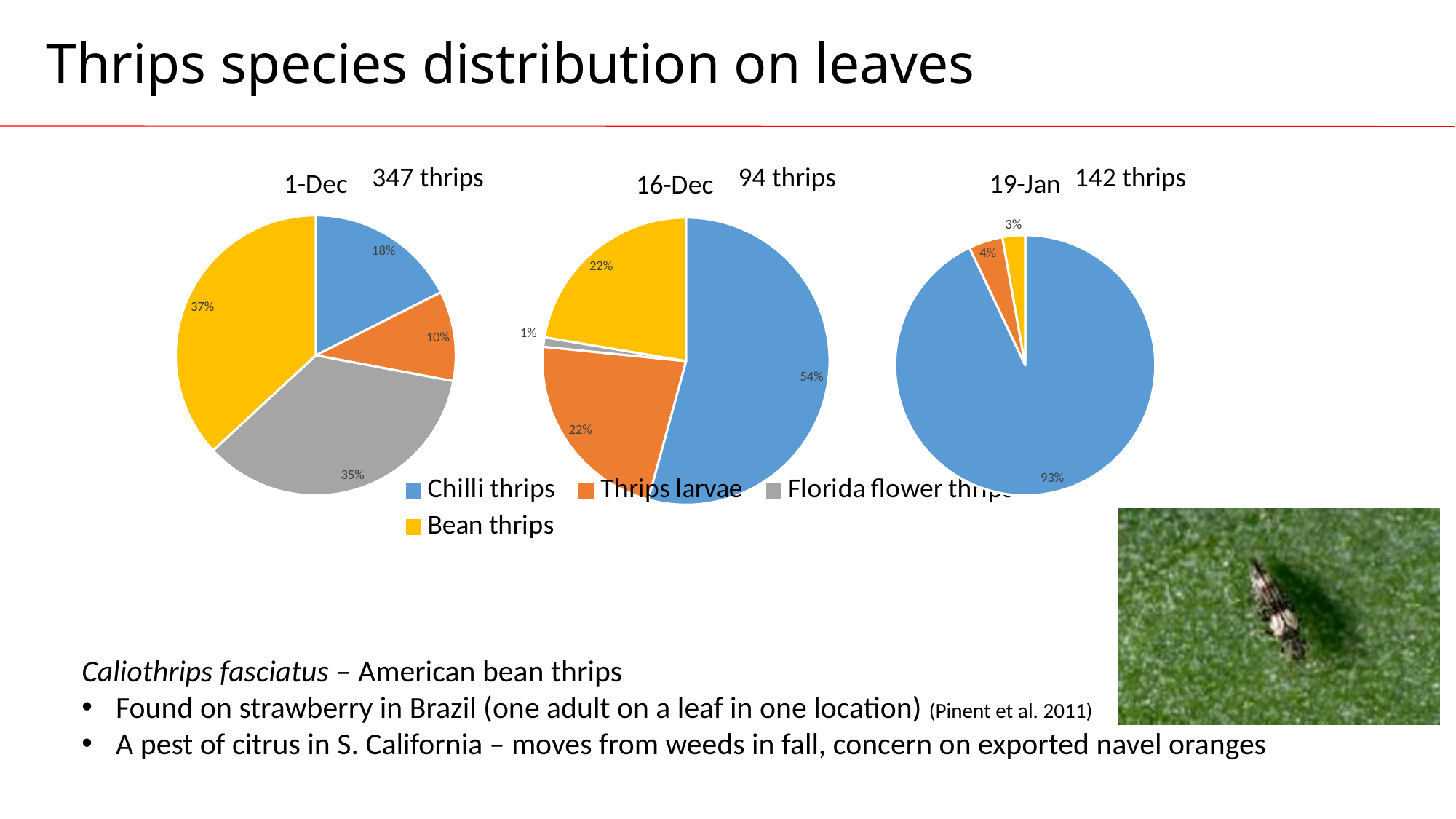
In the 1-Dec pie chart, what share is Bean thrips? 37% In the 16-Dec pie chart, what share is Florida flower thrips? 1% What kind of charts are shown on the slide? Pie charts In the 16-Dec pie chart, which species has the smallest slice? Florida flower thrips In the 16-Dec pie chart, what share is Chilli thrips? 54% In the 19-Jan pie chart, which species has the largest slice? Chilli thrips In the 1-Dec pie chart, what is the difference between the Bean thrips share and the Chilli thrips share? 19% How many species does the legend list? 4